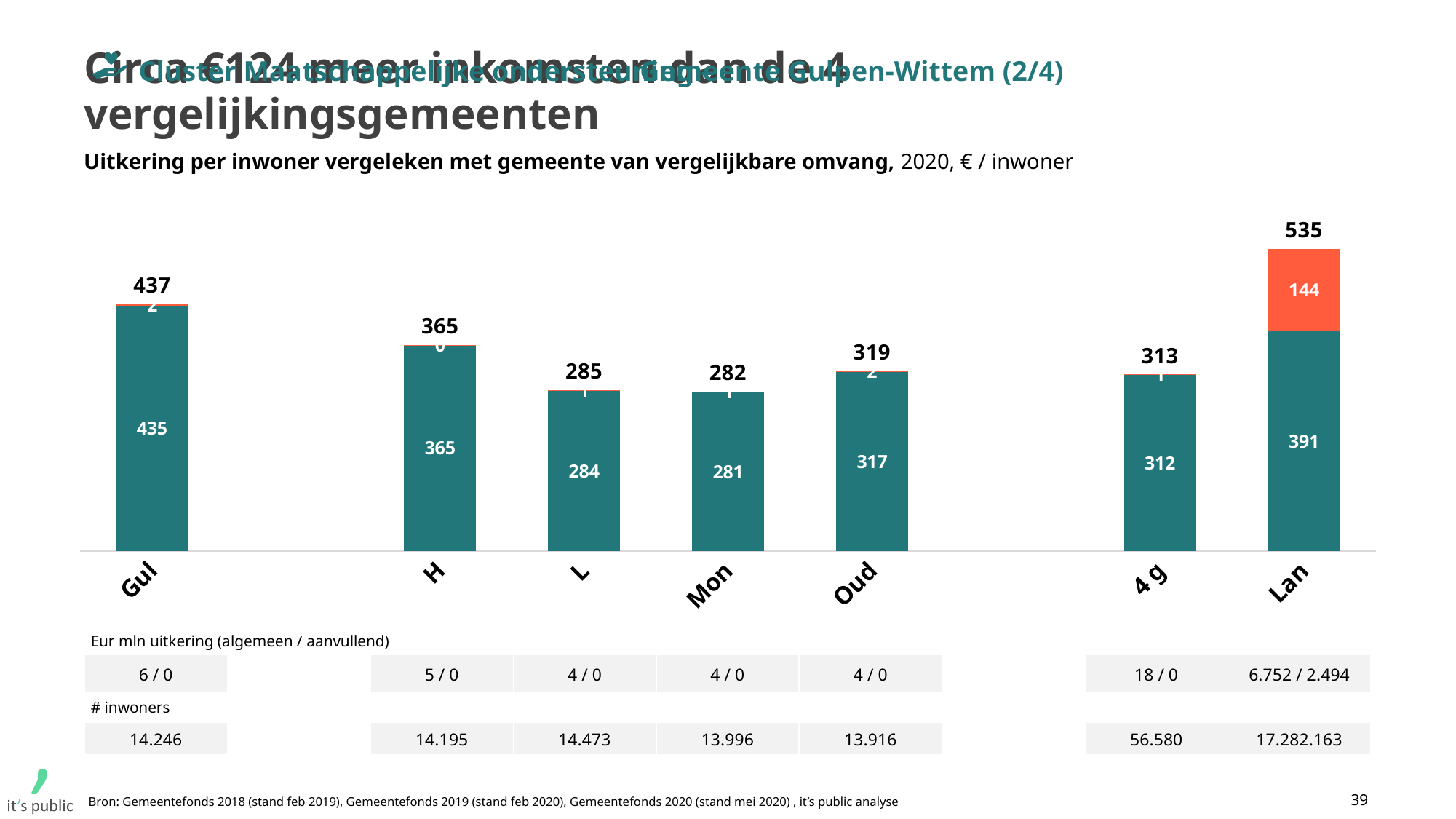
What is the value of the teal segment for Lan? 391 Which category has the highest total value? Lan What is the difference between the teal segment for Gul and the teal segment for H? 70 What is the difference between the total for Lan and the total for Gul? 98 What is the value of the orange segment for Lan? 144 What kind of chart is shown on the slide? Stacked bar chart Which category has the lowest total value? Mon Which has a larger total, H or 4 g? H What is the total value shown above the bar for Gul? 437 How many categories are shown on the x axis? 7 What is the total of the stacked bar for 4 g? 313 What is the total value shown above the bar for Oud? 319